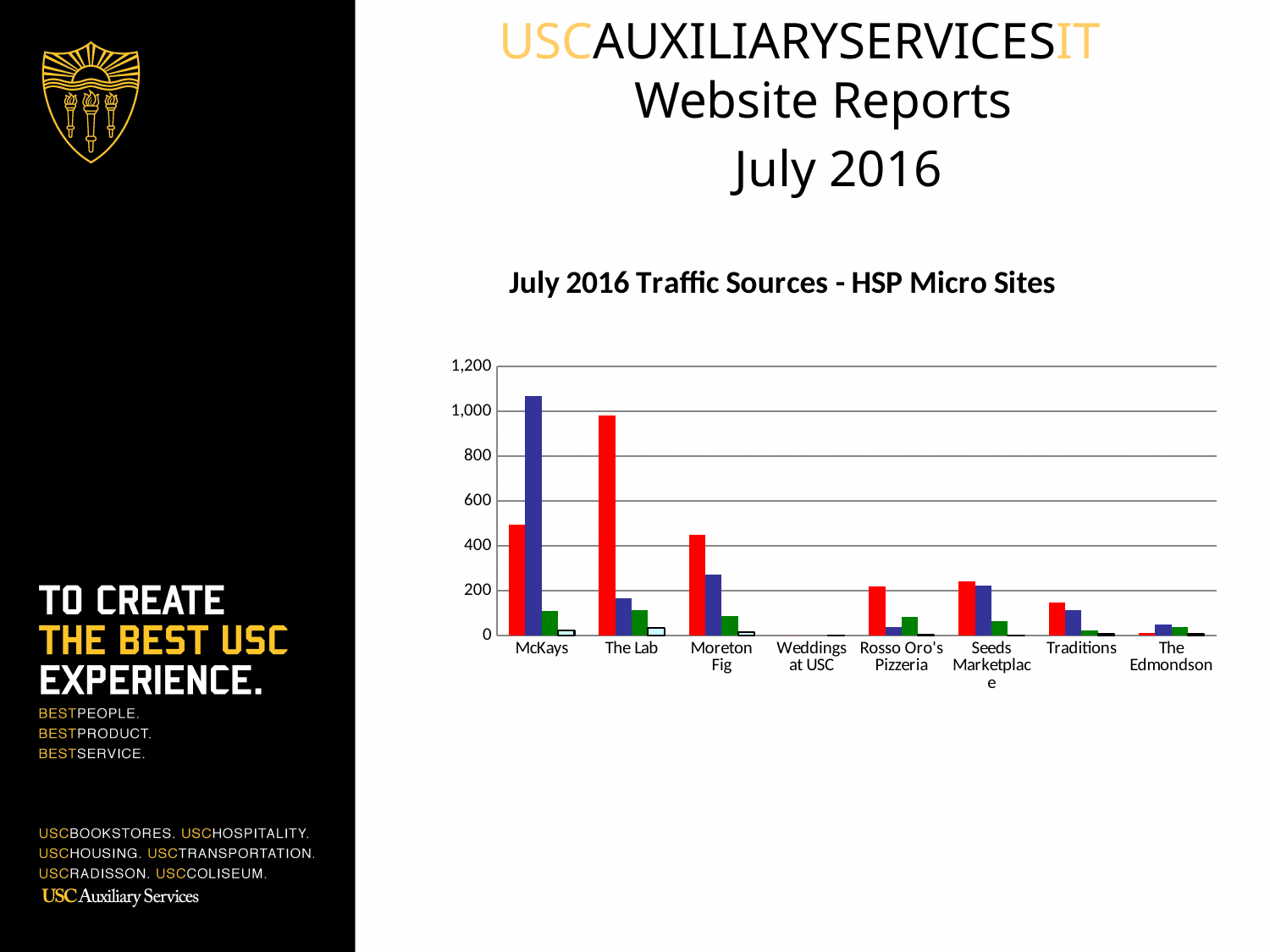
What kind of chart is shown on the slide? bar chart What is the title of the chart? July 2016 Traffic Sources - HSP Micro Sites Is the value of the red bar for Traditions greater or less than 200? less Which category has the lowest values overall, with all its bars near zero? Weddings at USC Is the value of the blue bar for McKays greater or less than 1,000? greater Which category has the tallest red bar? The Lab Is the value of the red bar for The Lab greater or less than 800? greater Which category contains the tallest bar in the chart? McKays Which is larger for McKays, the red bar or the blue bar? the blue bar Which is larger for The Lab, the red bar or the blue bar? the red bar How many categories are shown along the x axis of the chart? 8